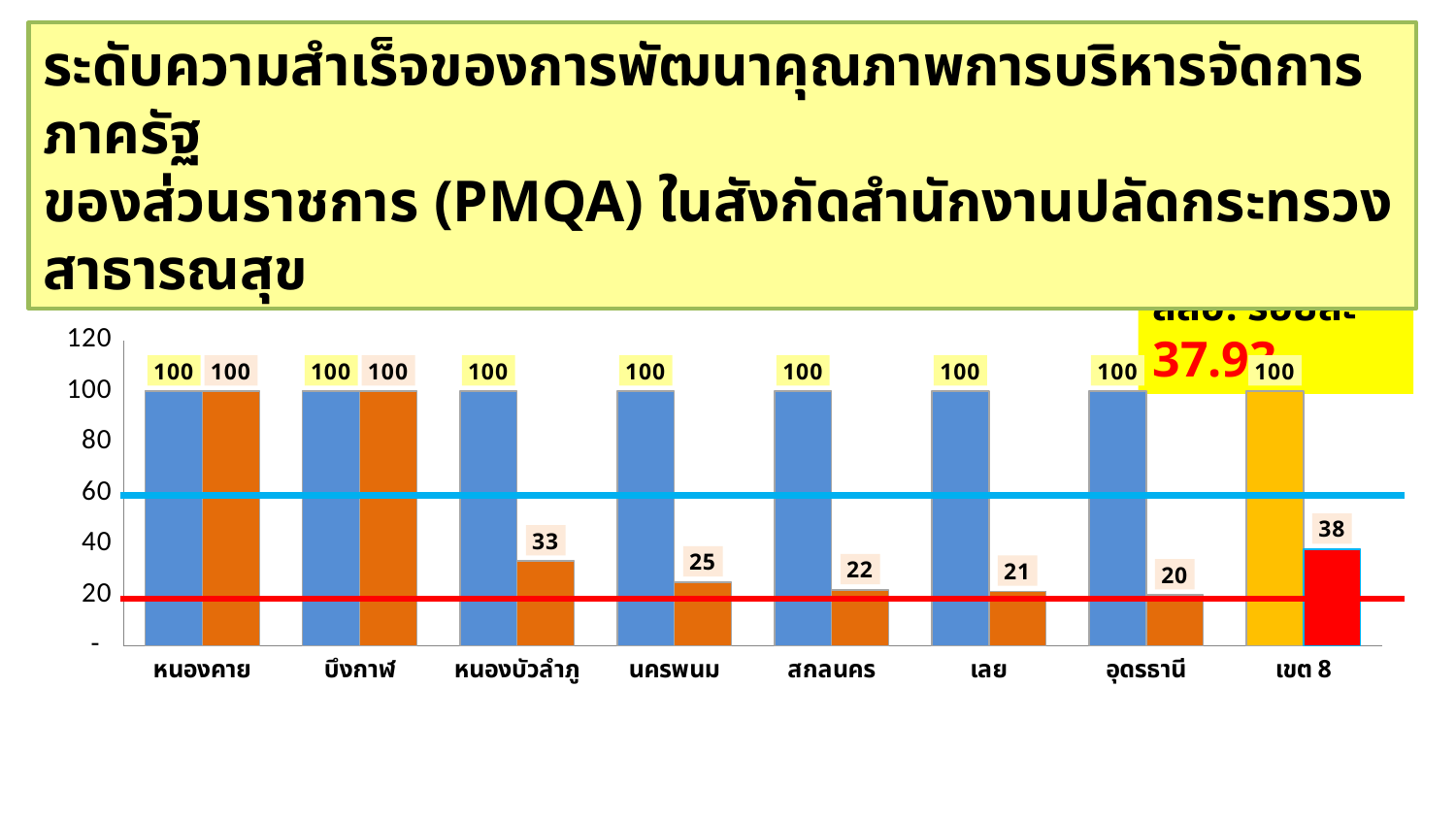
What is the value of the second (orange) bar for หนองบัวลำภู? 33 Do the second-bar values rise or fall from หนองบัวลำภู to อุดรธานี along the x axis? fall What is the highest tick value shown on the vertical axis? 120 Among the second bars of each category, which category has the lowest value? อุดรธานี Is the second-bar value for เขต 8 greater or less than 60? less What kind of chart is shown on the slide? bar chart What is the difference between the second-bar values of หนองบัวลำภู and อุดรธานี? 13 What is the value of the second bar for นครพนม? 25 Which is larger: the second-bar value for เลย or for สกลนคร? สกลนคร What is the value of the second (red) bar for เขต 8? 38 How many categories are shown on the x axis? 8 What is the value of the first (blue) bar for สกลนคร? 100